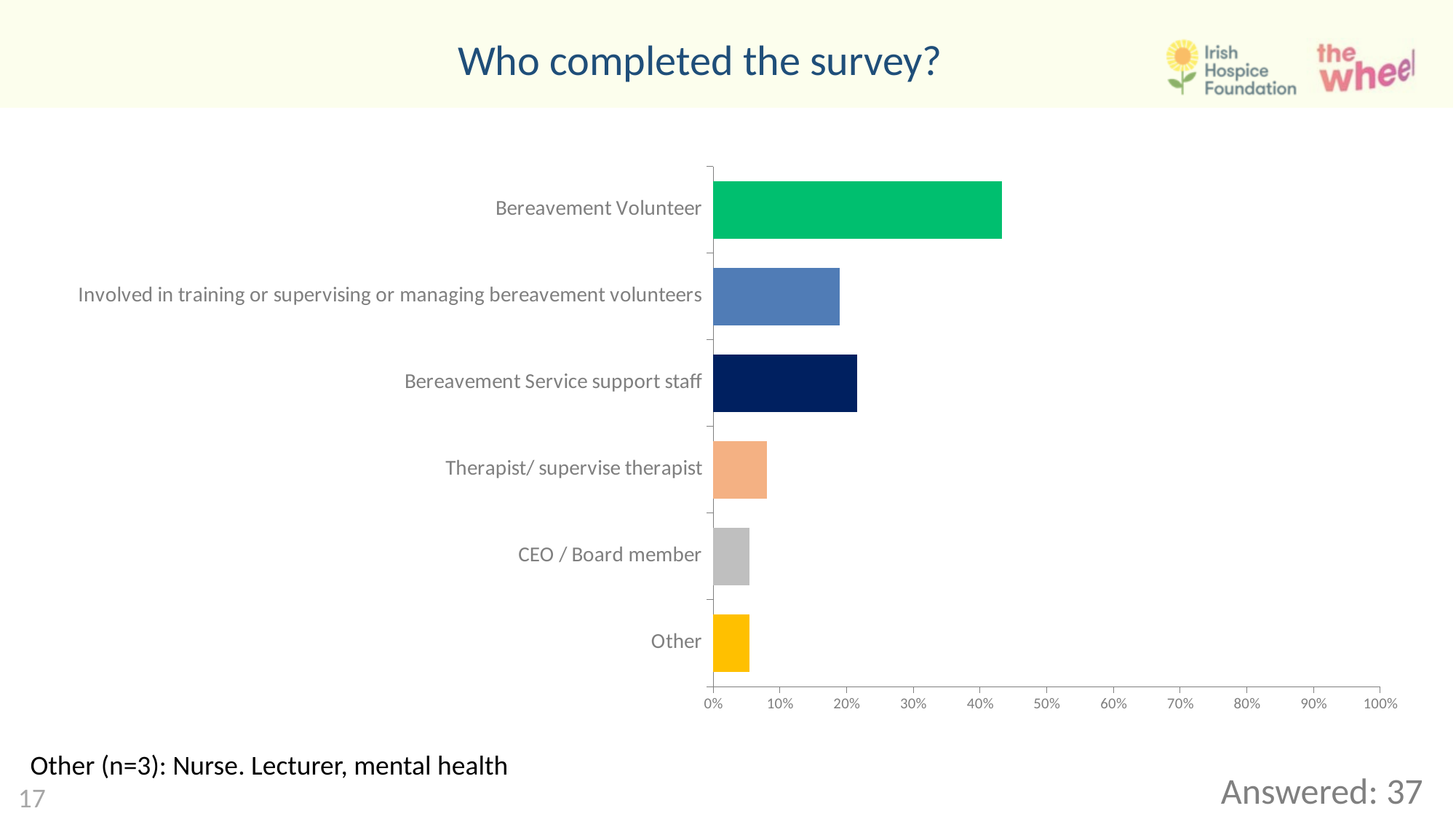
Is the value for Bereavement Service support staff greater or less than 30%? less Is the value for CEO / Board member greater or less than 10%? less Is the value for Therapist/ supervise therapist greater or less than 10%? less Which is larger, the value for Bereavement Service support staff or the value for Other? Bereavement Service support staff What is the highest value shown on the x axis of the chart? 100% Which category has the highest value in the chart? Bereavement Volunteer Which is larger, the value for Bereavement Volunteer or the value for Therapist/ supervise therapist? Bereavement Volunteer What is the title of the slide containing the chart? Who completed the survey? What kind of chart is shown on the slide? bar chart How many categories are plotted in the chart? 6